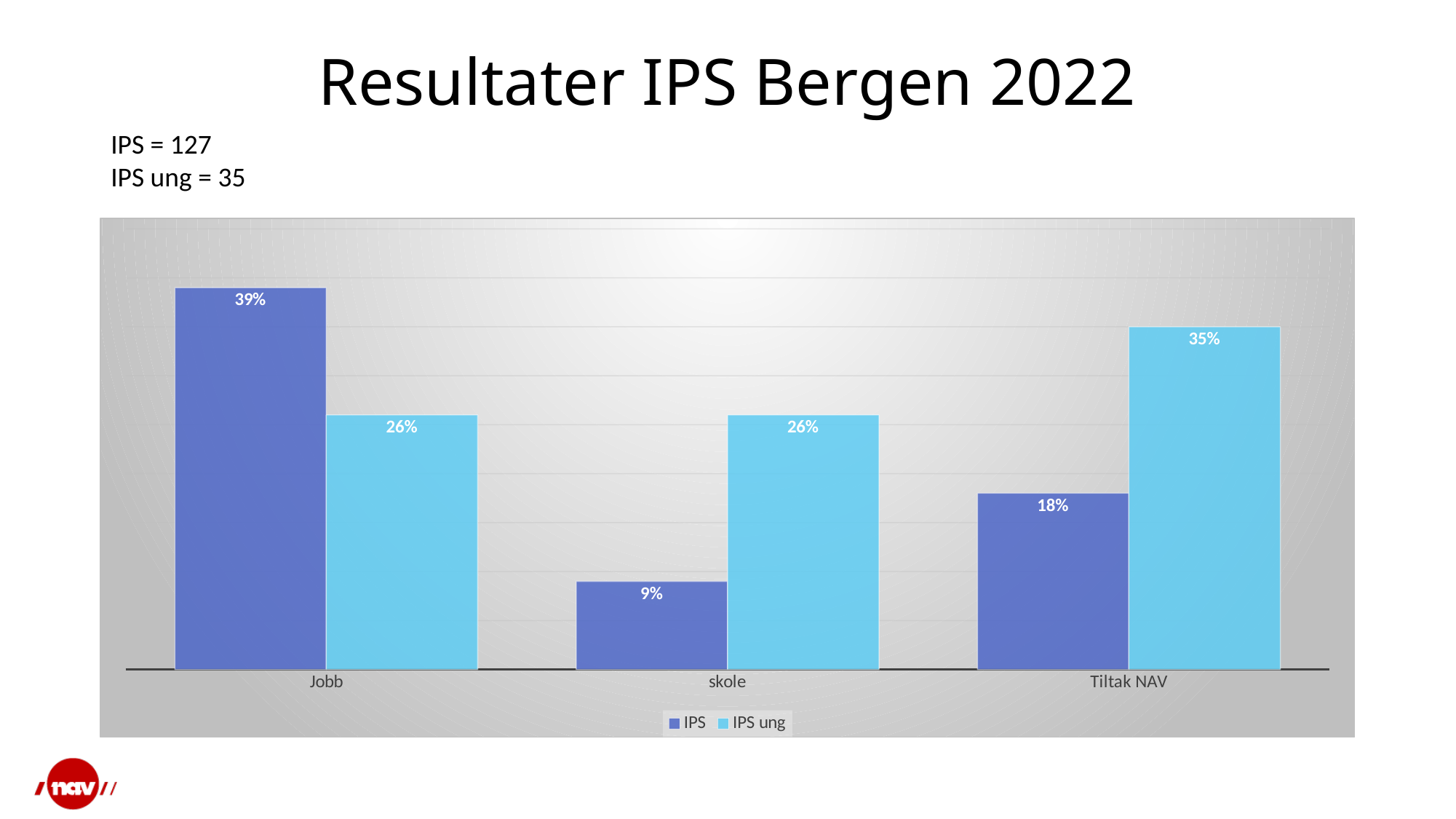
What is the difference between the IPS and IPS ung values for Jobb? 13% What is the IPS ung value for Tiltak NAV? 35% Which category has the highest IPS ung value? Tiltak NAV How many series does the legend list? 2 How many categories are shown on the x axis? 3 What is the IPS ung value for skole? 26% Which is larger for Tiltak NAV, the IPS value or the IPS ung value? IPS ung What kind of chart is shown on the slide? Bar chart Which category has the lowest IPS value? skole What is the IPS value for Jobb? 39% What is the IPS value for skole? 9% Which category has the highest IPS value? Jobb